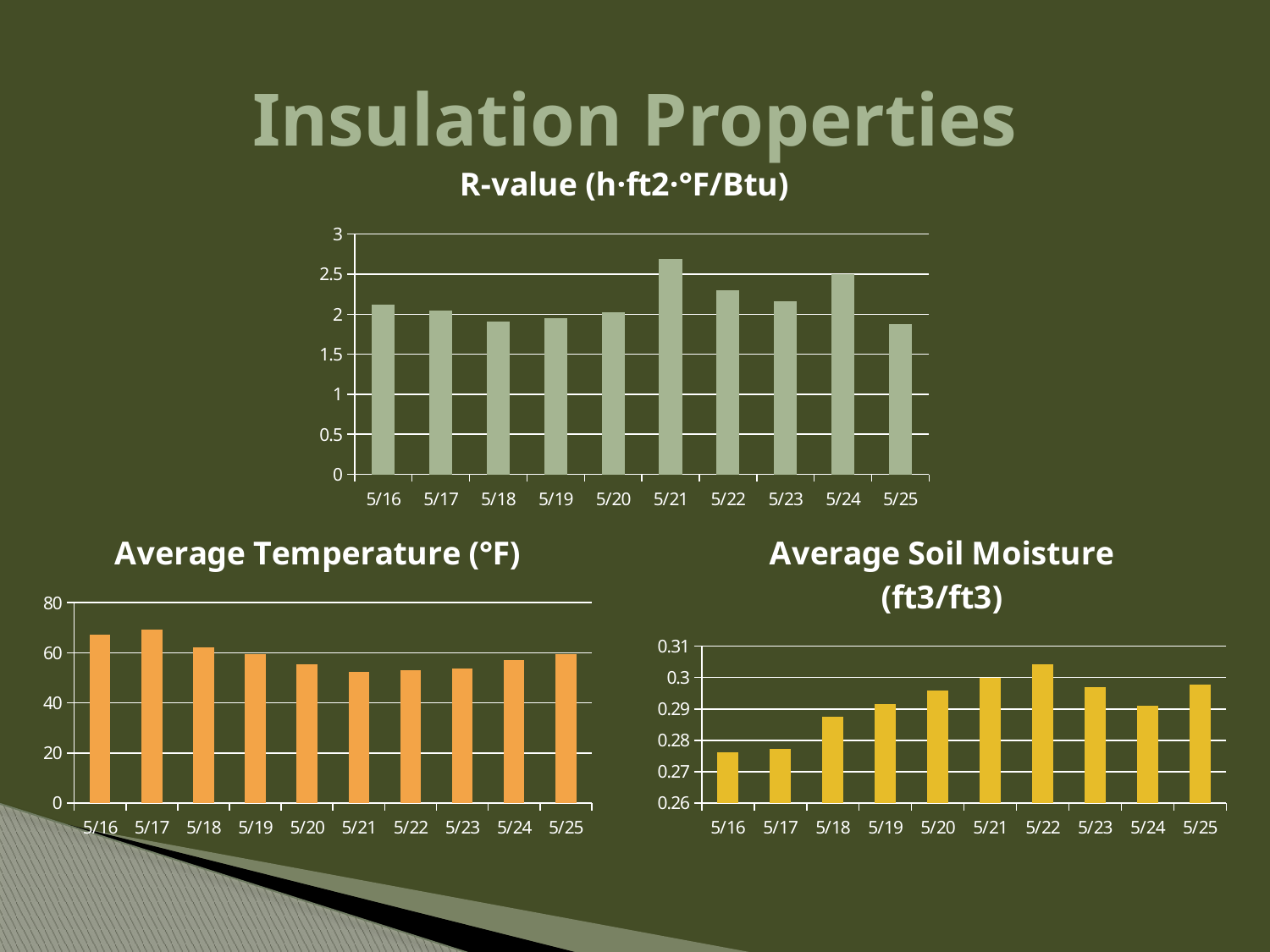
In the R-value chart, how many dates are plotted on the x axis? 10 In the R-value chart, which is larger, the value for 5/21 or the value for 5/22? 5/21 In the Average Soil Moisture (ft3/ft3) chart, is the value for 5/16 greater or less than 0.28? less What kind of chart is the Average Soil Moisture (ft3/ft3) chart? bar chart In the R-value chart, which date has the highest R-value? 5/21 In the R-value chart, is the value for 5/21 greater or less than 2.5? greater In the Average Temperature (°F) chart, which date has the highest average temperature? 5/17 In the Average Temperature (°F) chart, do the values rise or fall from 5/17 to 5/21? fall In the Average Temperature (°F) chart, is the value for 5/21 greater or less than 60? less In the Average Temperature (°F) chart, which is larger, the value for 5/16 or the value for 5/20? 5/16 In the Average Soil Moisture (ft3/ft3) chart, which date has the highest average soil moisture? 5/22